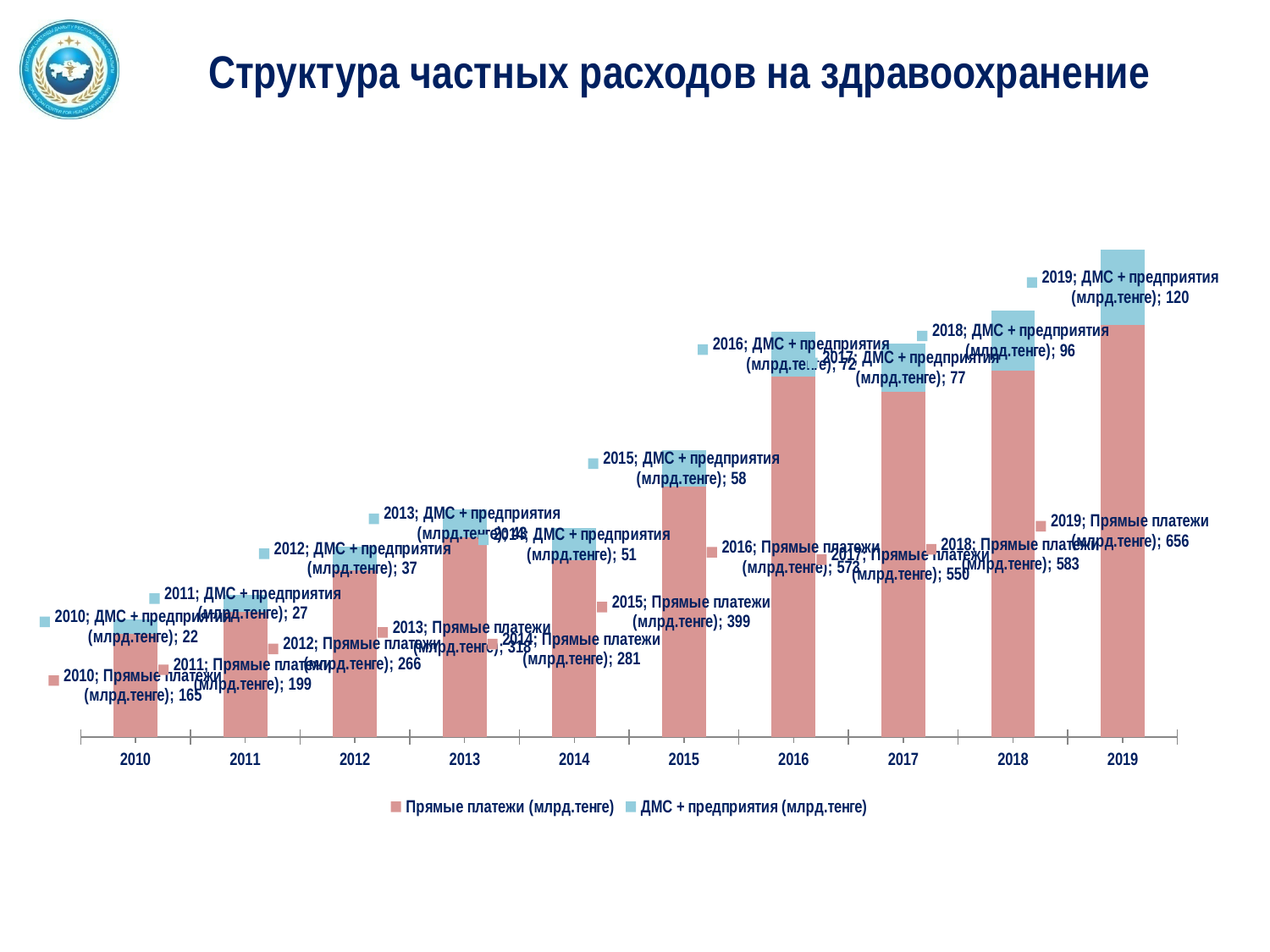
What is the value of Прямые платежи (млрд.тенге) for 2010? 165 What is the value of ДМС + предприятия (млрд.тенге) for 2015? 58 What is the total of the stacked bar for 2010? 187 Which year has the highest value for ДМС + предприятия (млрд.тенге)? 2019 What is the value of ДМС + предприятия (млрд.тенге) for 2019? 120 What is the value of Прямые платежи (млрд.тенге) for 2019? 656 How many series does the legend list? 2 How many years are shown on the x axis? 10 What is the total of the stacked bar for 2019? 776 What kind of chart is shown on the slide? bar chart Which year has the larger value for Прямые платежи, 2017 or 2018? 2018 What is the difference between Прямые платежи in 2019 and in 2010? 491